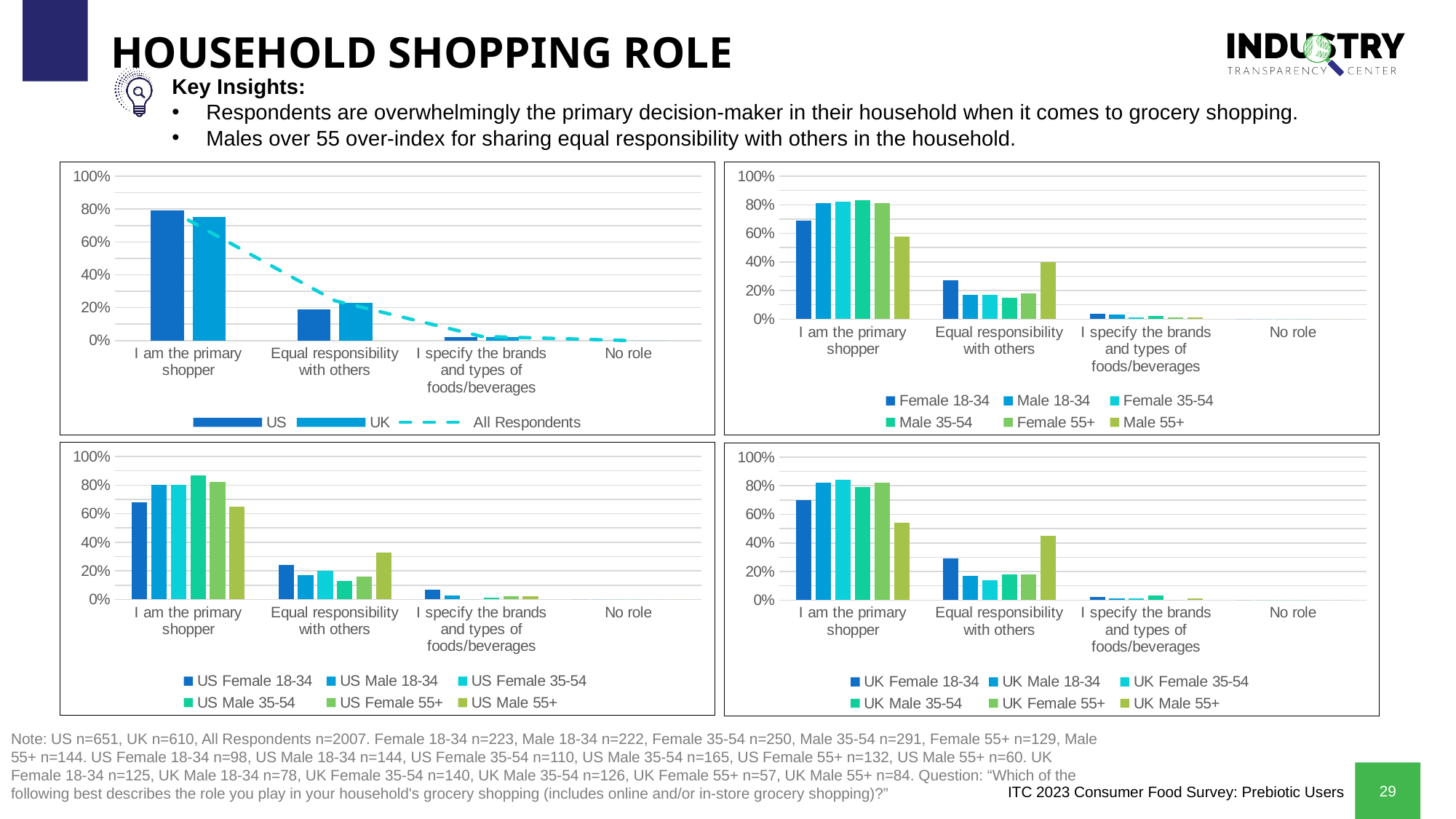
In the top-left chart, is the UK value for "Equal responsibility with others" greater or less than 40%? less In the bottom-right chart, is the UK Male 55+ value for "Equal responsibility with others" greater or less than 40%? greater In the top-right chart, how many series does the legend list? 6 In the top-left chart, does the All Respondents dashed line rise or fall from "I am the primary shopper" to "No role"? fall In the top-left chart, how many series does the legend list? 3 In the top-left chart, is the US value for "I am the primary shopper" greater or less than 60%? greater In the top-right chart, how many categories are shown on the x axis? 4 In the top-left chart, which is larger for "Equal responsibility with others", US or UK? UK In the top-right chart, which series has the highest value for "Equal responsibility with others"? Male 55+ In the bottom-right chart, which series has the lowest value for "I am the primary shopper"? UK Male 55+ What kind of chart is the bottom-left chart? bar chart